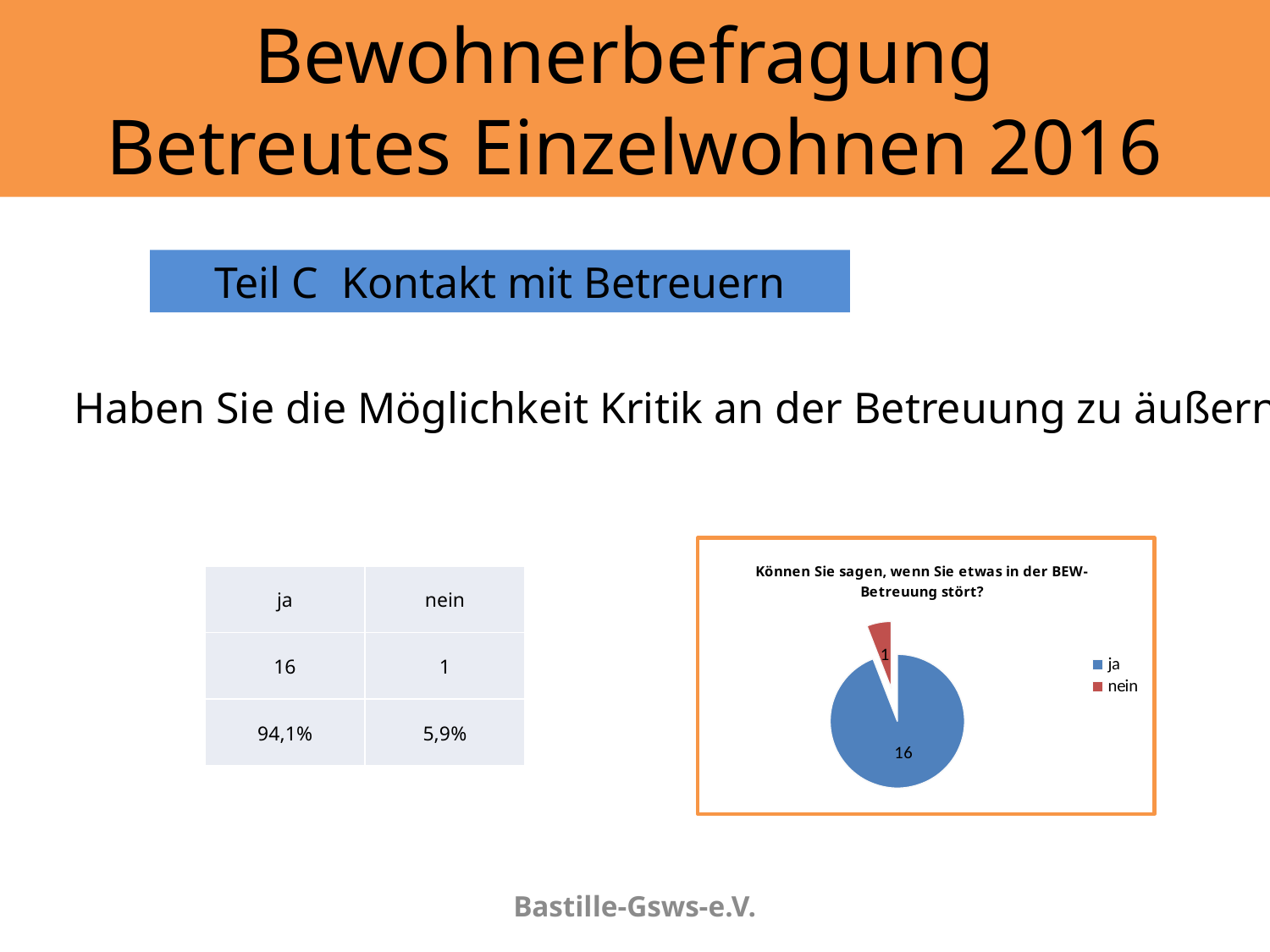
What is the value of the "nein" slice in the pie chart? 1 What is the title of the pie chart? Können Sie sagen, wenn Sie etwas in der BEW-Betreuung stört? What share of the pie does the "ja" slice represent? 94,1% What kind of chart is shown on the slide? pie chart What is the total of all slices in the pie chart? 17 How many slices does the pie chart have? 2 Which is larger in the pie chart, "ja" or "nein"? ja What is the difference between the "ja" and "nein" values in the pie chart? 15 Which slice of the pie chart is the largest? ja Which slice of the pie chart is the smallest? nein How many entries does the legend of the pie chart list? 2 What is the value of the "ja" slice in the pie chart? 16